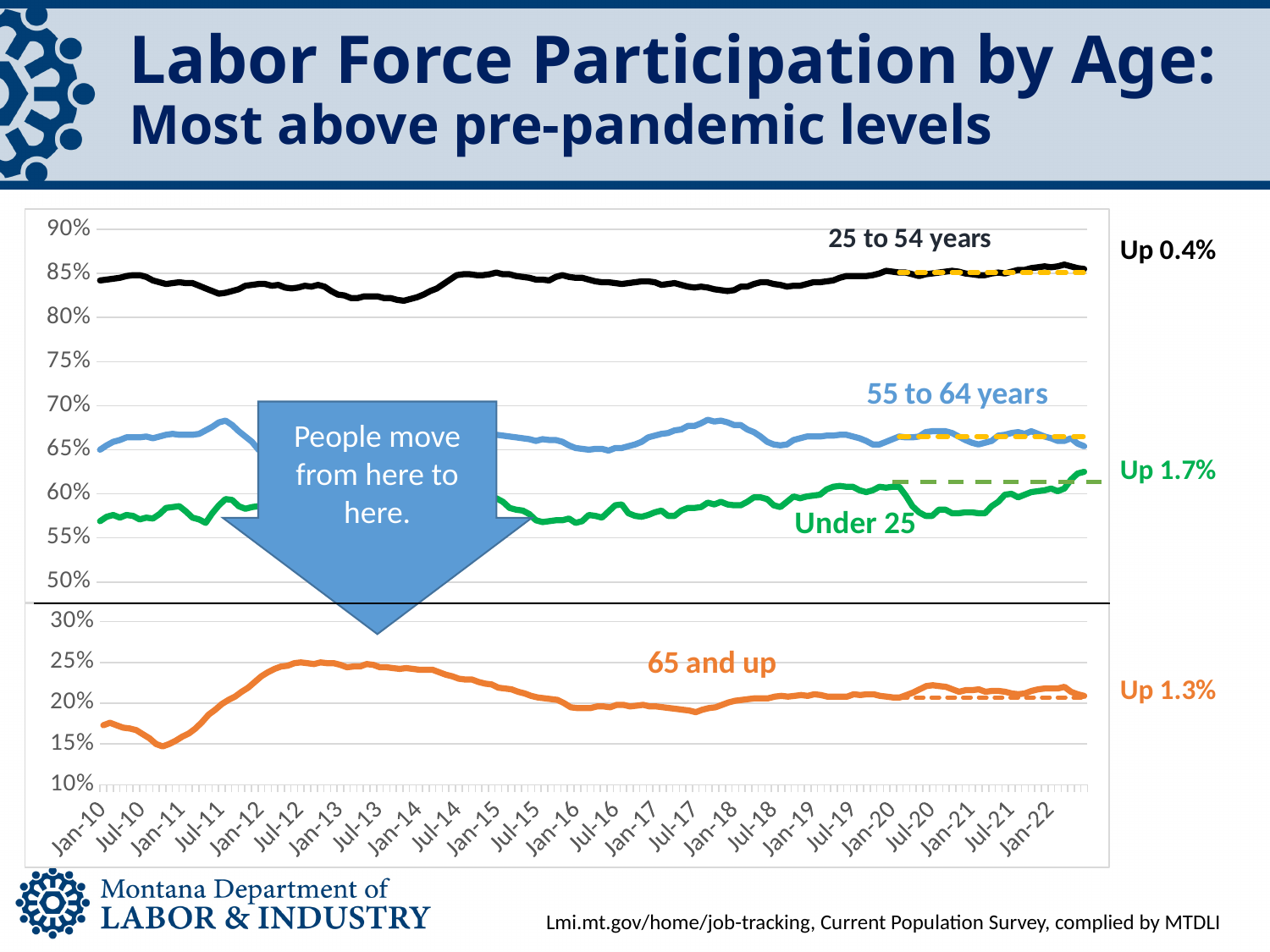
By how much is the Under 25 participation rate up compared with pre-pandemic levels, according to the annotation? Up 1.7% Which age group has the lowest labor force participation rate throughout the chart? 65 and up By how much is the 65 and up participation rate up compared with pre-pandemic levels, according to the annotation? Up 1.3% How many age-group series are plotted on the chart? 4 What kind of chart is shown on the slide? line chart Is the labor force participation rate for 25 to 54 years greater or less than 80% across the chart? greater Does the participation rate for 65 and up rise or fall between Jan-11 and Jul-12? rise Is the labor force participation rate for Under 25 in Jan-22 greater or less than 55%? greater Which is larger in Jan-22, the participation rate for 55 to 64 years or for Under 25? 55 to 64 years Which age group has the highest labor force participation rate throughout the chart? 25 to 54 years Is the labor force participation rate for 65 and up in Jan-11 greater or less than 20%? less By how much is the 25 to 54 years participation rate up compared with pre-pandemic levels, according to the annotation? Up 0.4%